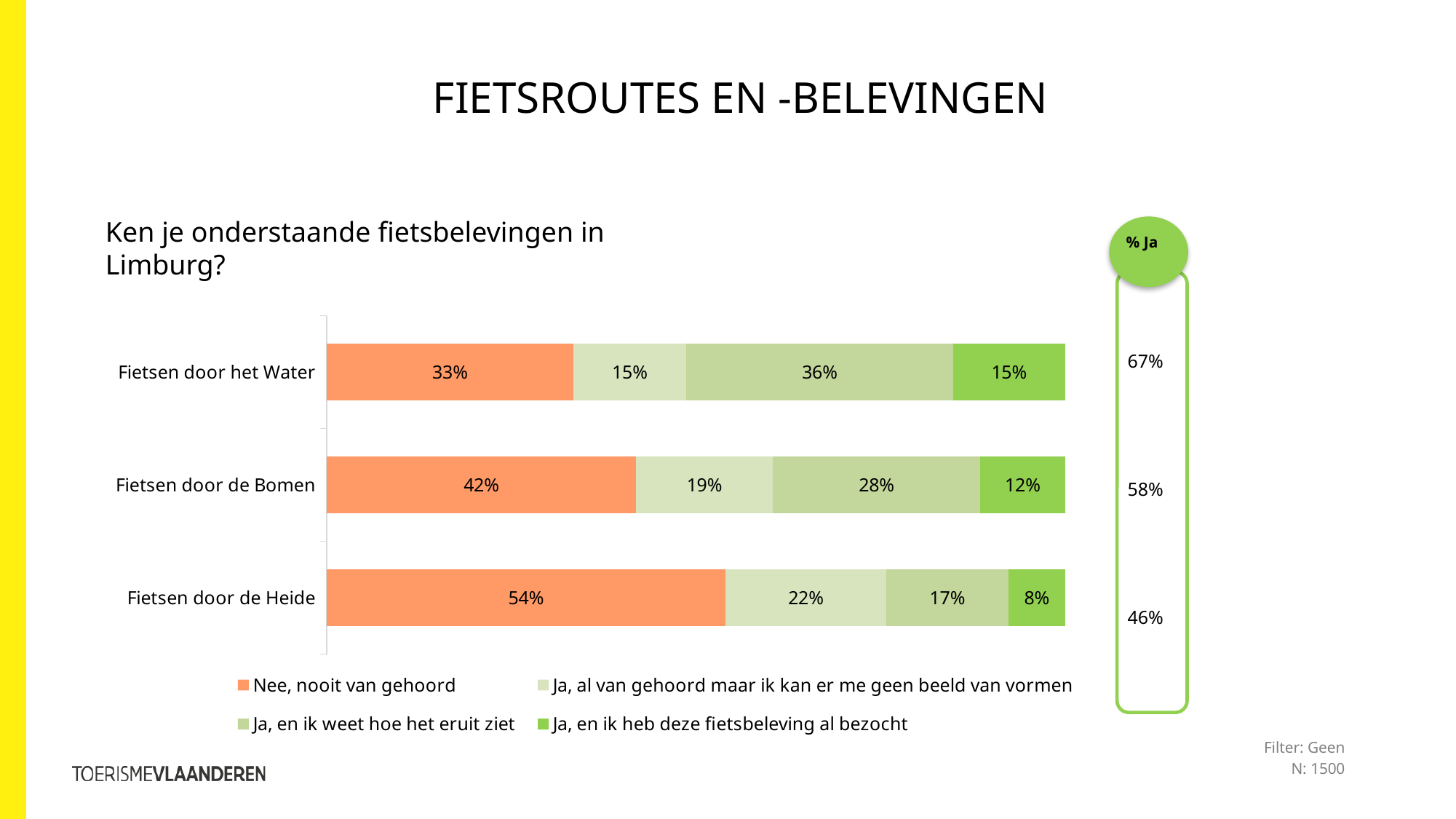
What is the % Ja value shown for Fietsen door de Bomen? 58% Which category has the highest share of "Nee, nooit van gehoord"? Fietsen door de Heide What kind of chart is shown on the slide? Stacked bar chart How many series does the legend list? 4 What colour represents "Nee, nooit van gehoord" in the chart? Orange How many cycling experiences (categories) are shown in the chart? 3 What is the value of "Ja, en ik weet hoe het eruit ziet" for Fietsen door de Bomen? 28% How many percentage points higher is "Nee, nooit van gehoord" for Fietsen door de Heide than for Fietsen door het Water? 21 percentage points What percentage of respondents answered "Nee, nooit van gehoord" for Fietsen door de Heide? 54% Which has a larger "Ja, al van gehoord maar ik kan er me geen beeld van vormen" share: Fietsen door de Bomen or Fietsen door het Water? Fietsen door de Bomen Which category has the lowest share of "Ja, en ik heb deze fietsbeleving al bezocht"? Fietsen door de Heide What is the value of "Ja, en ik heb deze fietsbeleving al bezocht" for Fietsen door het Water? 15%